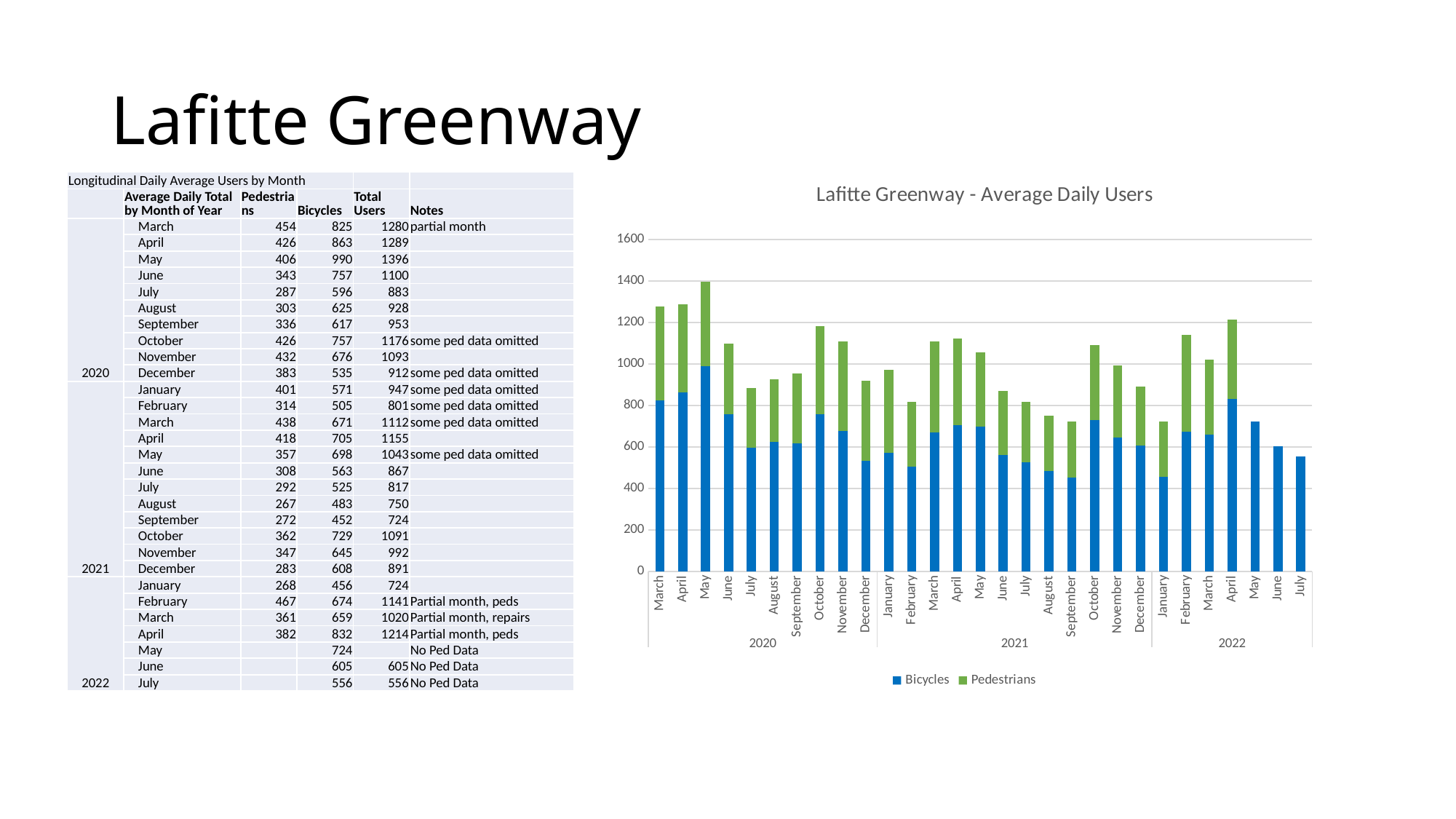
Is the total stacked bar for May 2020 greater or less than 1200? greater What are the two series named in the chart legend? Bicycles and Pedestrians What is the difference between the Total Users for May 2020 and June 2020? 296 What is the title of the chart? Lafitte Greenway - Average Daily Users What kind of chart is shown on the slide? bar chart Do the stacked bar totals rise or fall from April 2022 to July 2022? fall How many series does the chart legend list? 2 Is the bar for July 2022 greater or less than 800? less Which month has the tallest stacked bar in the chart? May 2020 According to the table, what is the Bicycles value for April 2022? 832 According to the table, what is the Total Users value for May 2020? 1396 Which is larger, the total stacked bar for October 2020 or October 2021? October 2020